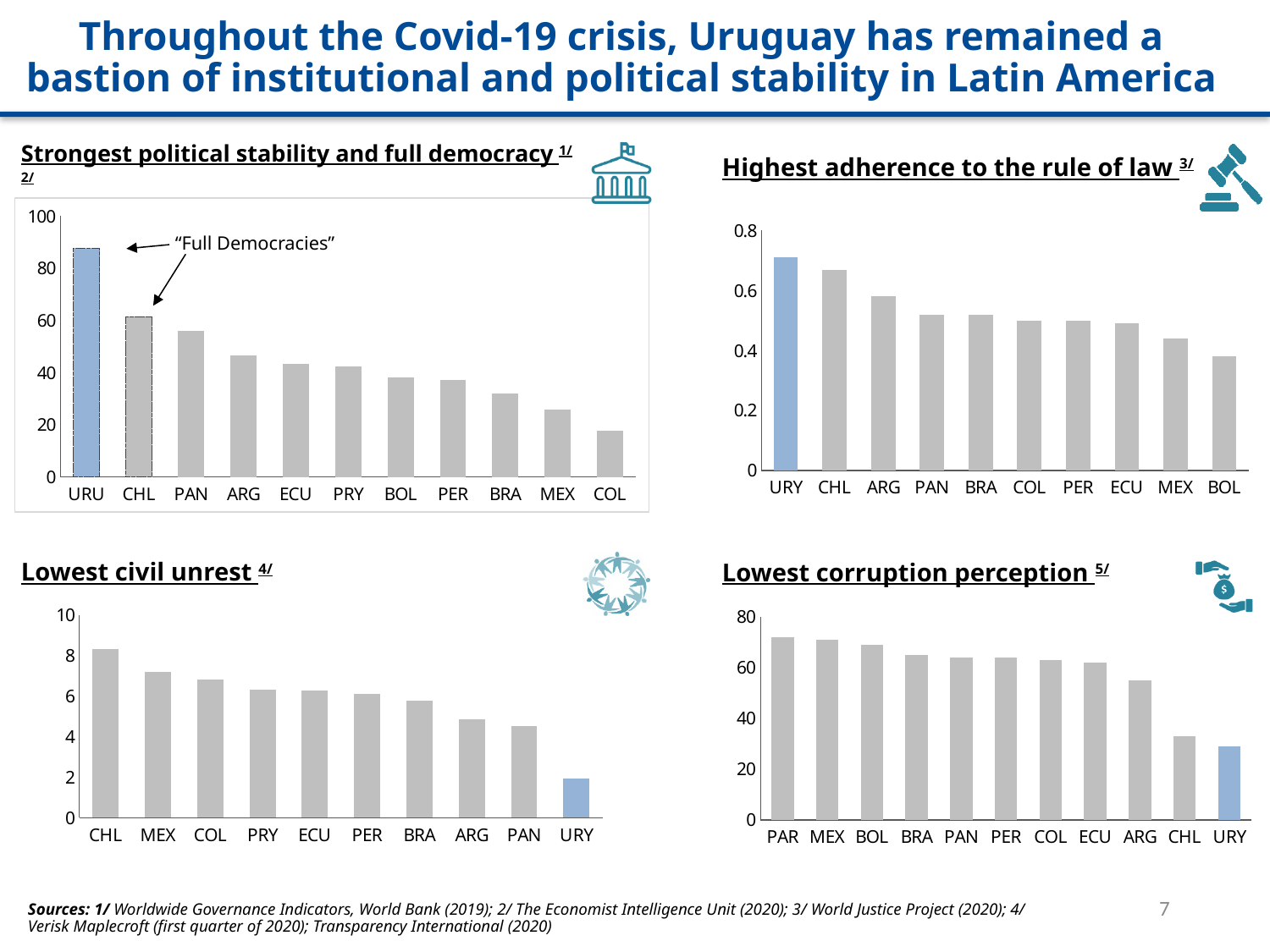
How many countries are shown in the 'Strongest political stability and full democracy' chart? 11 In the 'Highest adherence to the rule of law' chart, which country has the lowest value? BOL In the 'Highest adherence to the rule of law' chart, is the value for URY greater or less than 0.6? greater What kind of chart is the 'Lowest corruption perception' chart? bar chart In the 'Lowest civil unrest' chart, which country has the highest value? CHL In the 'Strongest political stability and full democracy' chart, which two countries are labelled as 'Full Democracies'? URU and CHL In the 'Strongest political stability and full democracy' chart, which country has the lowest value? COL How many countries are shown in the 'Highest adherence to the rule of law' chart? 10 In the 'Strongest political stability and full democracy' chart, is the value for URU greater or less than 80? greater In the 'Lowest corruption perception' chart, which is larger, the value for PAR or the value for URY? PAR In the 'Strongest political stability and full democracy' chart, which country has the highest value? URU